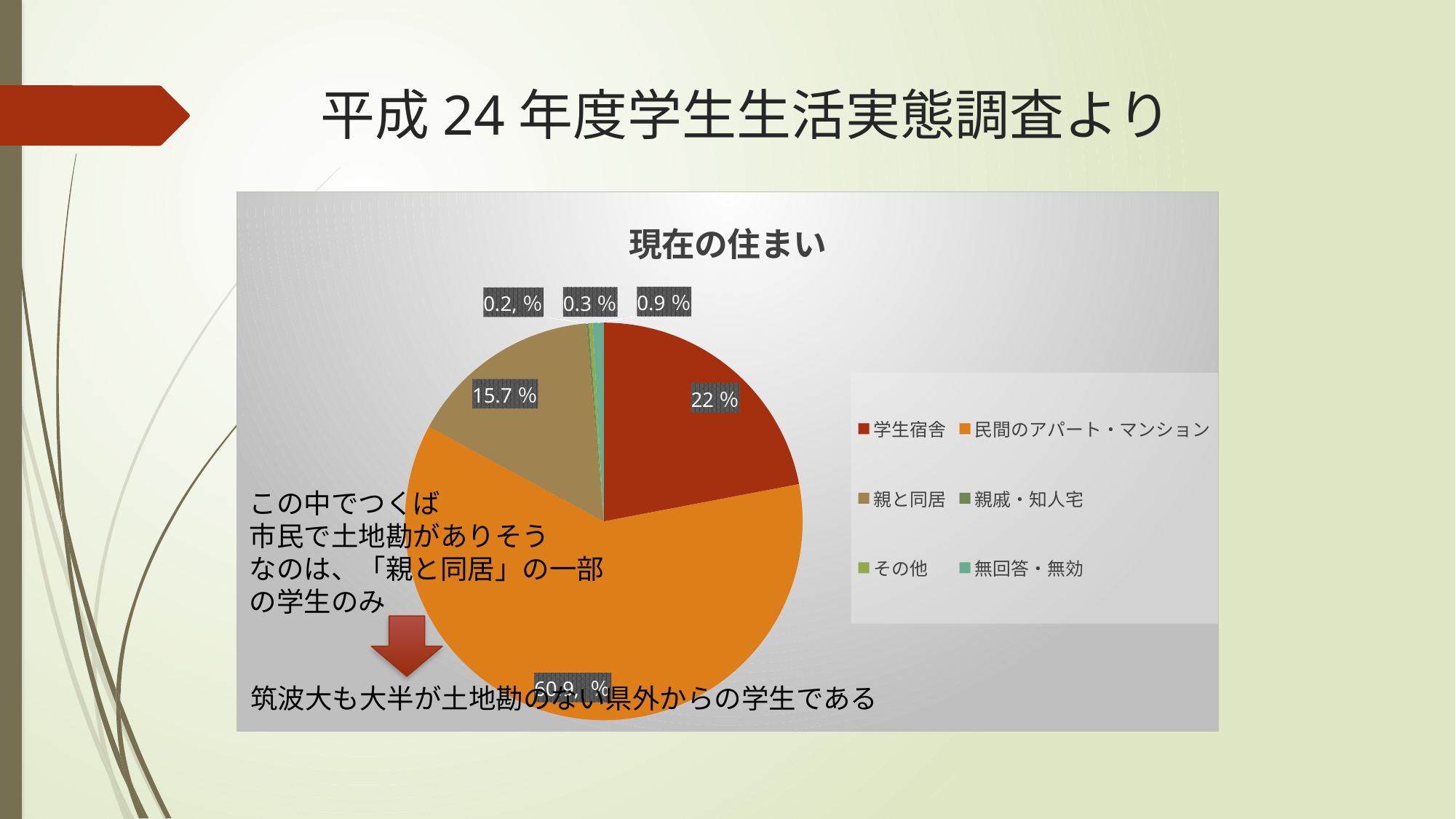
What share of the pie does 親と同居 represent? 15.7 % Which is larger, the slice for 学生宿舎 or the slice for 親と同居? 学生宿舎 What is the title of the chart? 現在の住まい What percentage is shown for 民間のアパート・マンション? 60.9 % What percentage is shown for 学生宿舎? 22 % What kind of chart is shown on the slide? pie chart What percentage is shown for 親と同居? 15.7 % How many categories does the chart's legend list? 6 What is the difference between the percentages for 民間のアパート・マンション and 学生宿舎? 38.9 % What is the difference between the percentages for 学生宿舎 and 親と同居? 6.3 % Which category has the largest slice of the pie? 民間のアパート・マンション What colour is the slice for 民間のアパート・マンション? orange